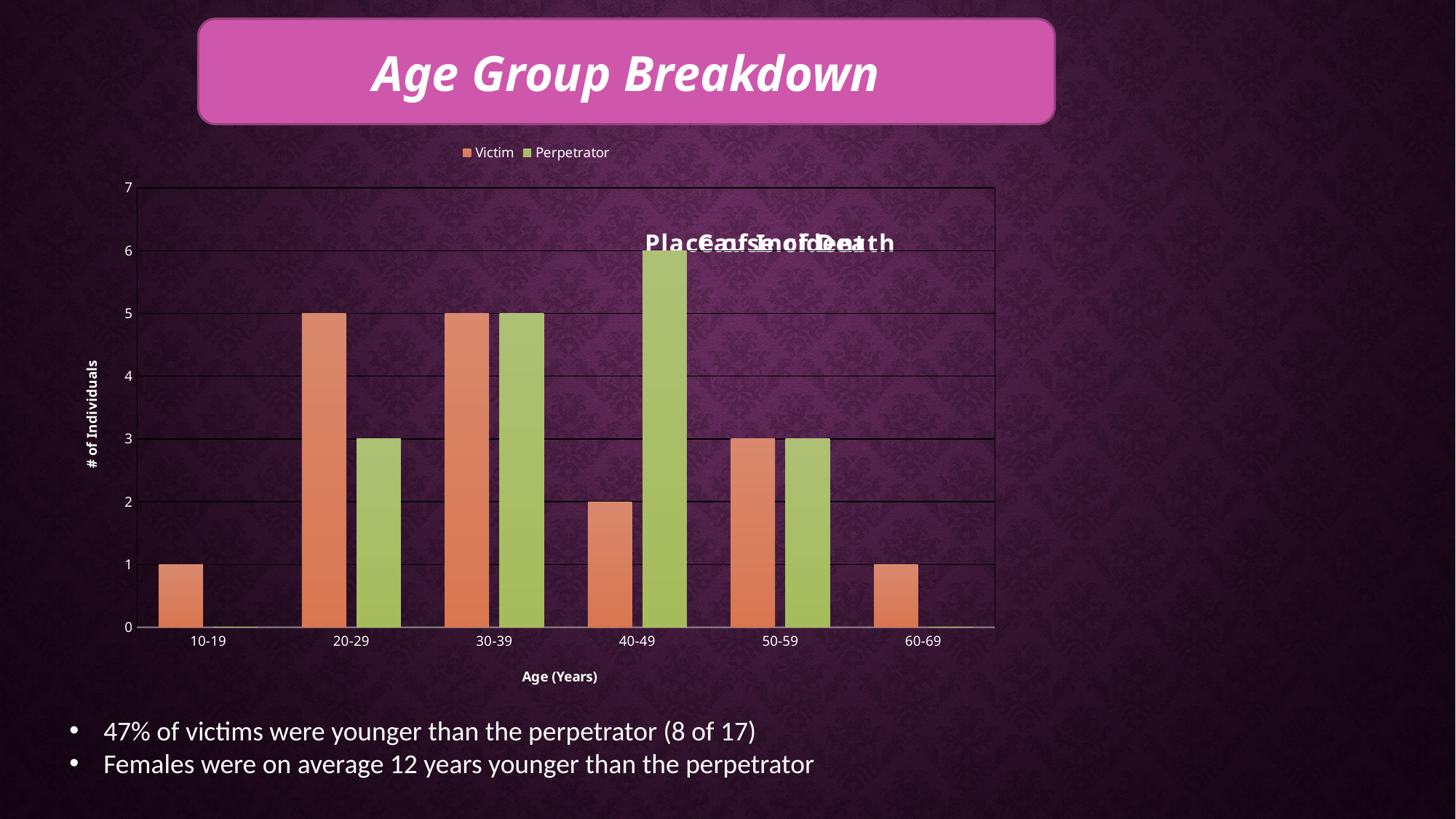
What is the label of the y axis? # of Individuals What type of chart is shown on the slide? bar chart Which age group has the lowest number of victims? 10-19 and 60-69 How many series does the legend list? 2 Is the number of perpetrators in the 30-39 age group greater or less than 4? greater Which age group has the highest number of perpetrators? 40-49 How many age group categories are shown on the x axis? 6 In the 40-49 age group, which is larger: the number of victims or the number of perpetrators? Perpetrator What is the number of perpetrators in the 40-49 age group? 6 What is the number of victims in the 60-69 age group? 1 What is the difference between the number of victims and perpetrators in the 20-29 age group? 2 What is the number of victims in the 20-29 age group? 5